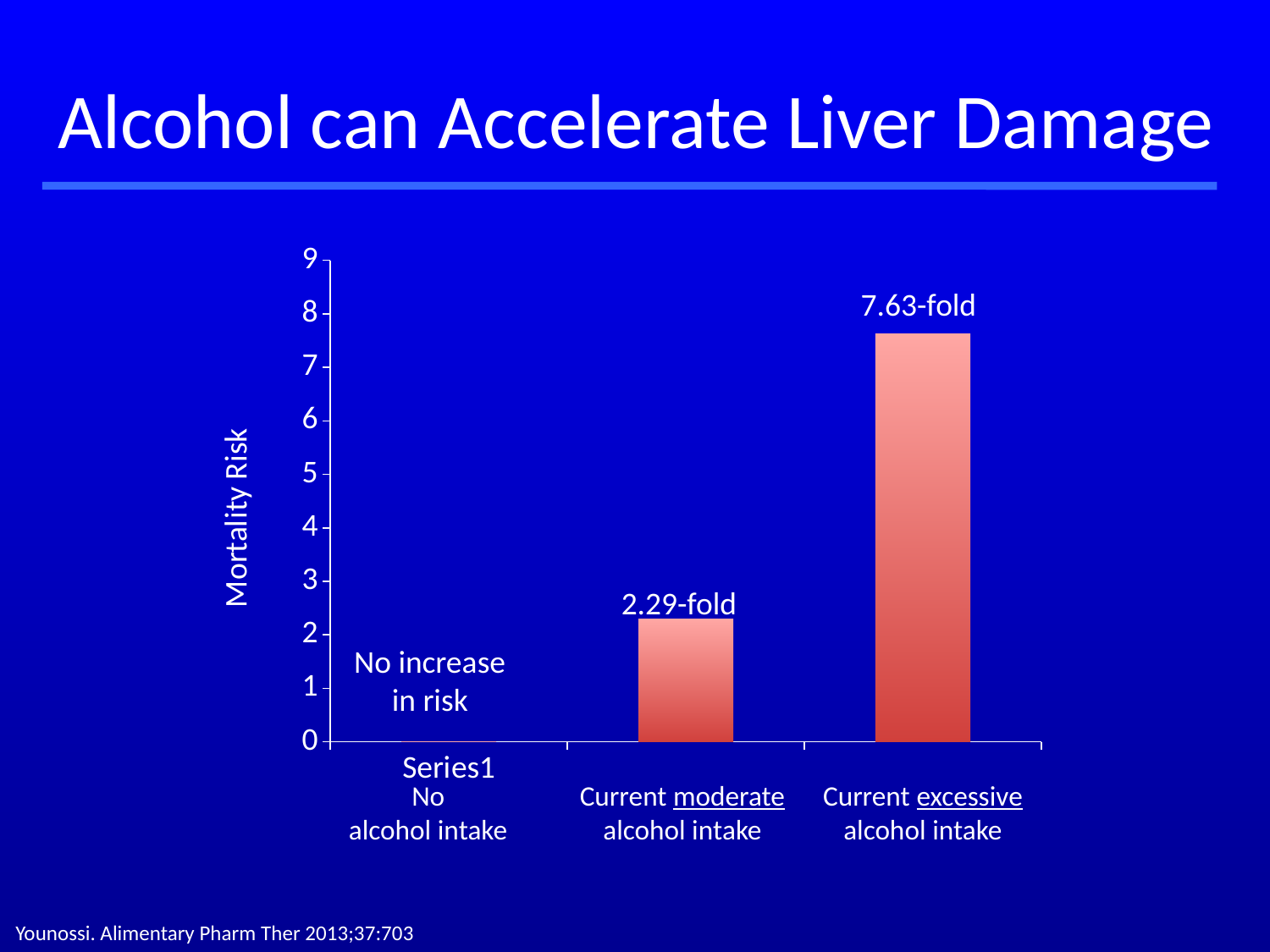
What is the label of the vertical axis? Mortality Risk Is the value for current moderate alcohol intake greater or less than 3? less Which is larger, the mortality risk for current moderate alcohol intake or current excessive alcohol intake? Current excessive alcohol intake How many categories are shown on the x axis of the chart? 3 What kind of chart is shown on the slide? Bar chart What is the difference between the mortality risk for current excessive alcohol intake and current moderate alcohol intake? 5.34-fold Which category has the highest mortality risk? Current excessive alcohol intake What is the mortality risk value shown for current moderate alcohol intake? 2.29-fold What label is shown for the no alcohol intake category? No increase in risk Is the value for current excessive alcohol intake greater or less than 7? greater Which category has the lowest mortality risk? No alcohol intake What is the mortality risk value shown for current excessive alcohol intake? 7.63-fold